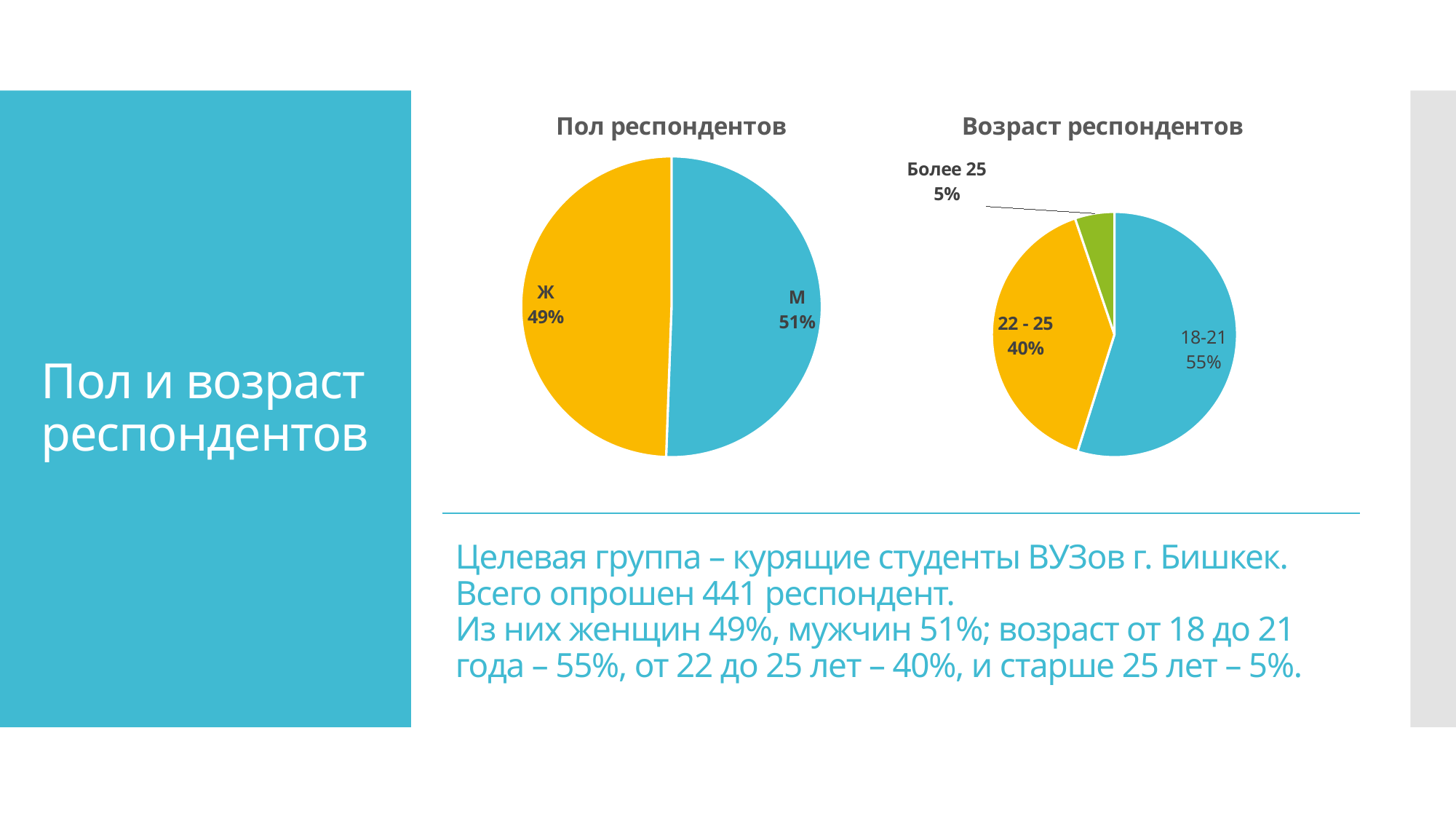
In the "Возраст респондентов" chart, what share of respondents is aged 22 - 25? 40% In the "Пол респондентов" chart, what share of respondents is labelled Ж? 49% In the "Пол респондентов" chart, which slice is larger, Ж or М? М In the "Пол респондентов" chart, what share of respondents is labelled М? 51% In the "Возраст респондентов" chart, what share of respondents is labelled "Более 25"? 5% How many slices does the "Возраст респондентов" chart have? 3 In the "Возраст респондентов" chart, which age group has the largest share? 18-21 In the "Возраст респондентов" chart, which age group has the smallest share? Более 25 In the "Пол респондентов" chart, what is the difference between the М and Ж shares? 2% In the "Возраст респондентов" chart, what share of respondents is aged 18-21? 55% What kind of chart is "Пол респондентов"? Pie chart In the "Возраст респондентов" chart, what is the difference between the 18-21 and 22 - 25 shares? 15%